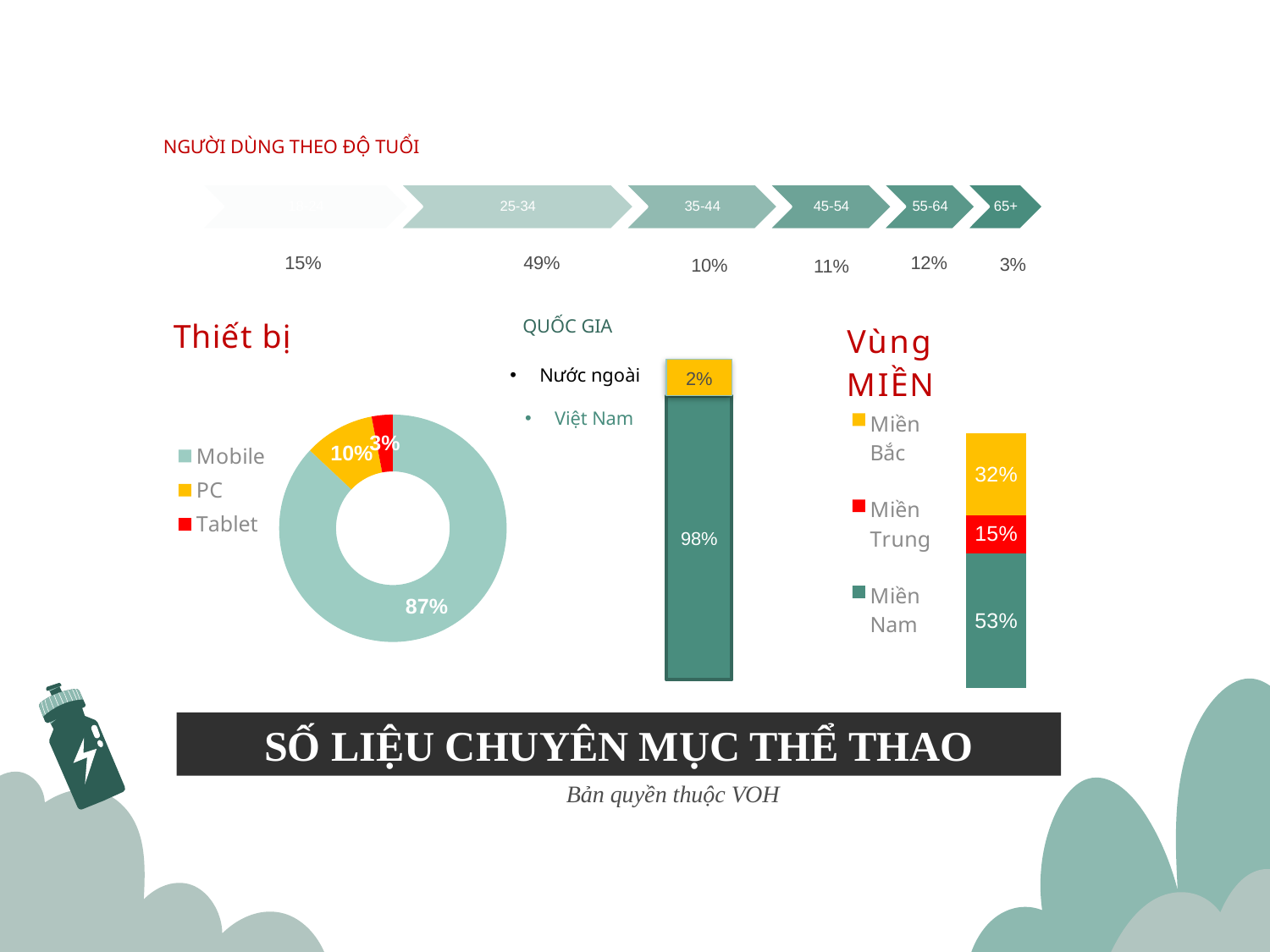
In the "Thiết bị" chart, what share is PC? 10% In the "QUỐC GIA" chart, what is the value for Nước ngoài? 2% In the "QUỐC GIA" chart, what is the difference between Việt Nam and Nước ngoài? 96% In the "Thiết bị" chart, which device has the smallest share? Tablet In the "Vùng MIỀN" chart, what is the value for Miền Bắc? 32% In the "Thiết bị" chart, what share is Mobile? 87% In the "Vùng MIỀN" chart, which is larger, Miền Bắc or Miền Trung? Miền Bắc In the "Vùng MIỀN" chart, which region has the largest value? Miền Nam What kind of chart is the "Thiết bị" chart? Donut chart How many categories does the "Thiết bị" chart legend list? 3 In the "QUỐC GIA" chart, what is the value for Việt Nam? 98% In the "Vùng MIỀN" chart, what is the difference between Miền Nam and Miền Trung? 38%